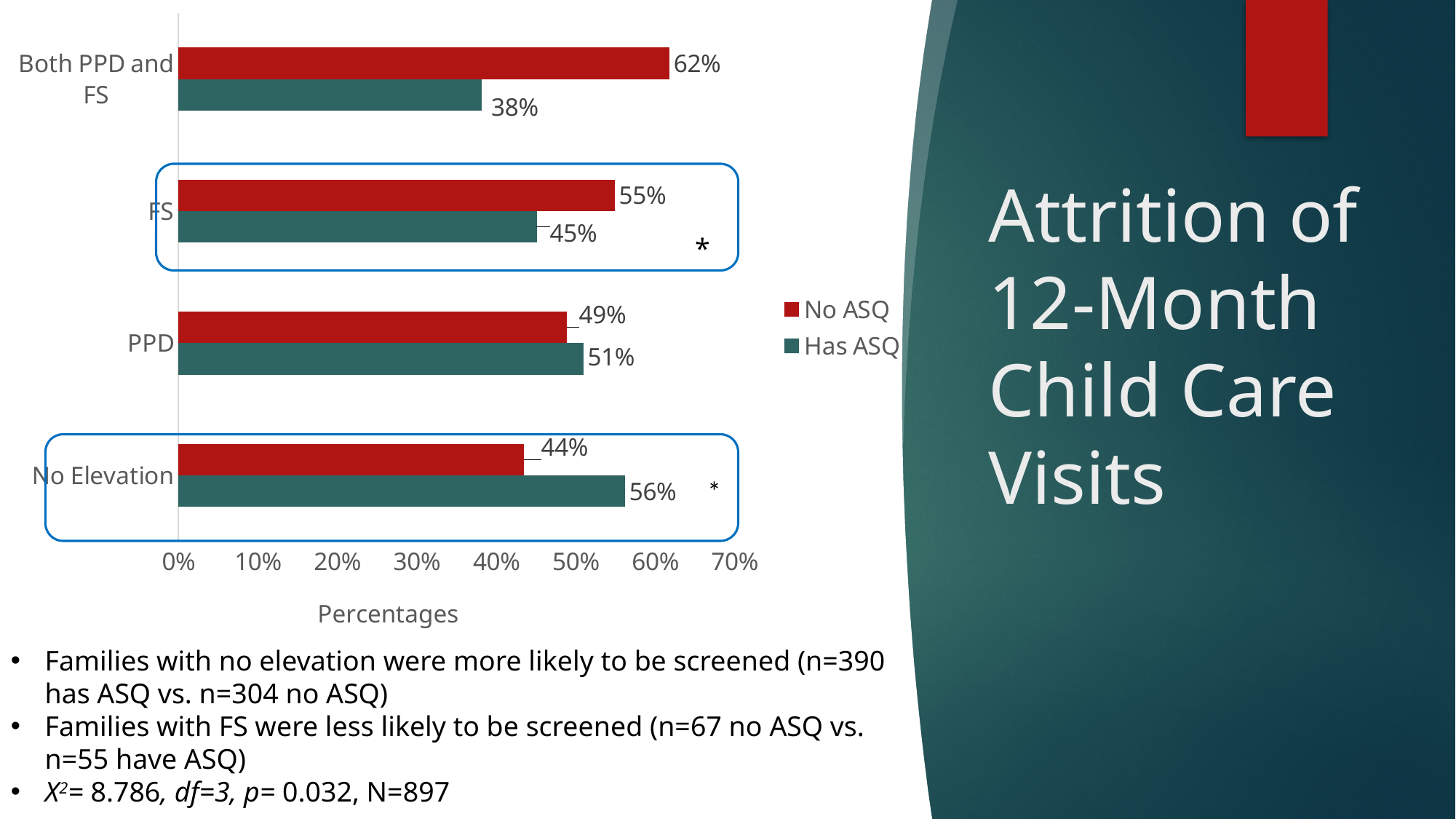
What is the No ASQ value for PPD? 49% Which category has the highest No ASQ value? Both PPD and FS What is the No ASQ value for Both PPD and FS? 62% How many categories are shown on the chart? 4 For No Elevation, which series has the larger value, No ASQ or Has ASQ? Has ASQ What is the Has ASQ value for FS? 45% What kind of chart is shown on the slide? Bar chart What is the difference between the No ASQ and Has ASQ values for Both PPD and FS? 24% What is the Has ASQ value for No Elevation? 56% How many series does the legend list? 2 Which category has the lowest Has ASQ value? Both PPD and FS What is the label of the horizontal axis? Percentages